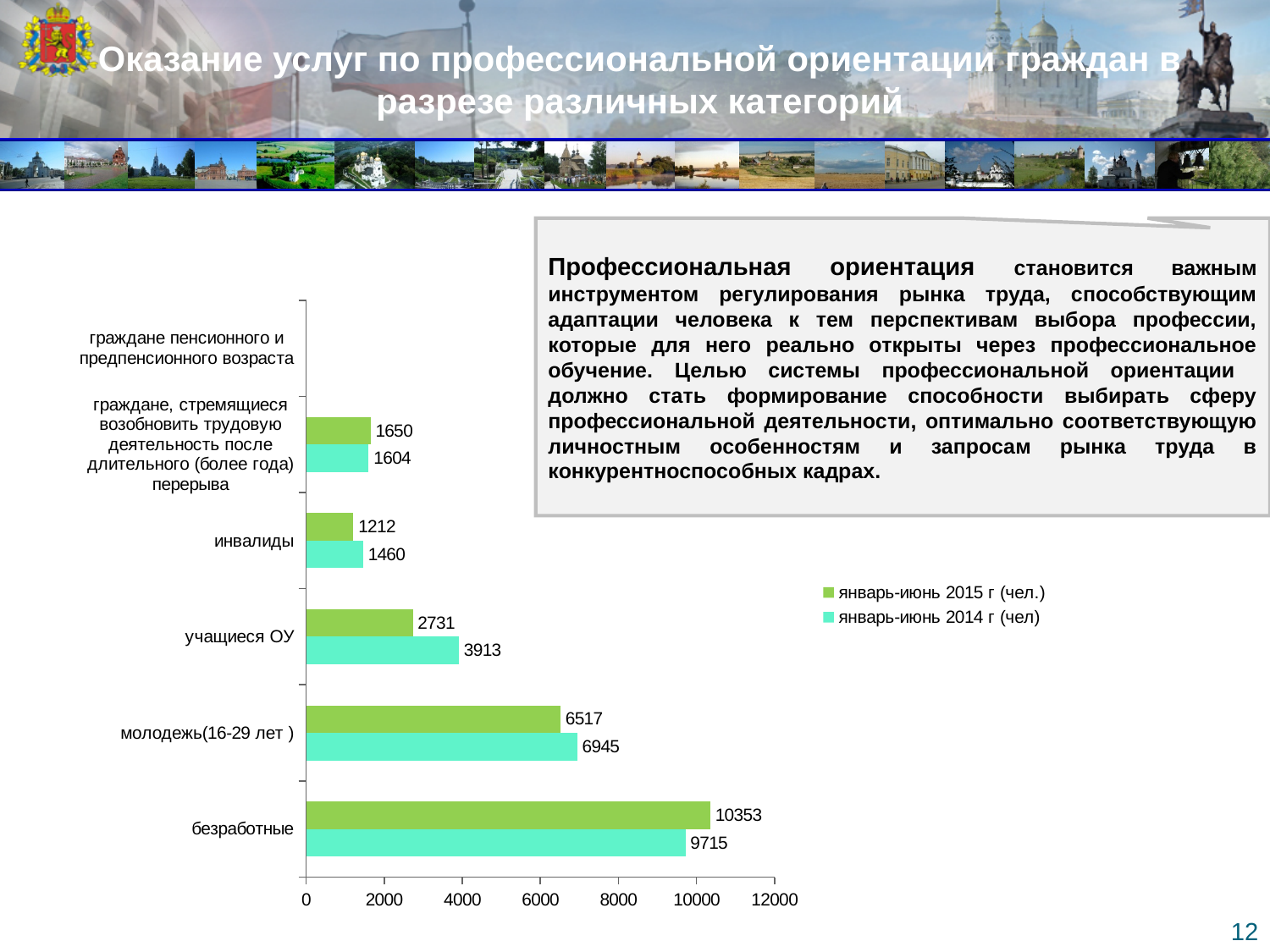
Is the value for молодежь(16-29 лет ) in the январь-июнь 2015 г (чел.) series greater or less than 6000? greater What is the difference between the январь-июнь 2015 г (чел.) and январь-июнь 2014 г (чел) values for безработные? 638 What is the value for учащиеся ОУ in the январь-июнь 2014 г (чел) series? 3913 What is the value for молодежь(16-29 лет ) in the январь-июнь 2014 г (чел) series? 6945 For учащиеся ОУ, which series has the larger value: январь-июнь 2015 г (чел.) or январь-июнь 2014 г (чел)? январь-июнь 2014 г (чел) What is the value for безработные in the январь-июнь 2015 г (чел.) series? 10353 What is the difference between the январь-июнь 2014 г (чел) and январь-июнь 2015 г (чел.) values for инвалиды? 248 What kind of chart is shown on the slide? bar chart What is the value for инвалиды in the январь-июнь 2015 г (чел.) series? 1212 How many series does the legend list? 2 Which category has the highest value in the январь-июнь 2015 г (чел.) series? безработные Which category has the lowest value in the январь-июнь 2014 г (чел) series among those with bars shown? инвалиды